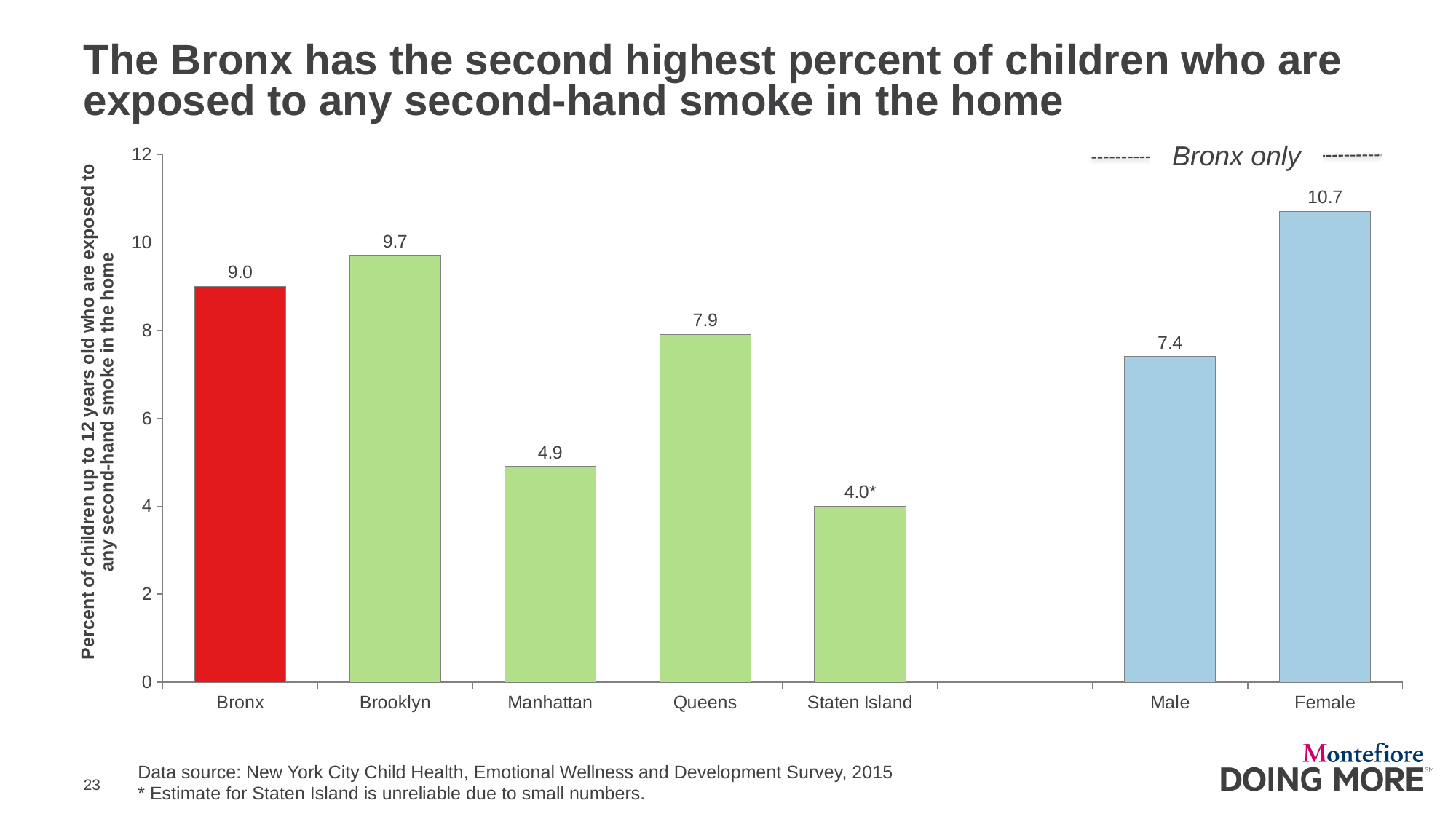
What is the value for Female in the Bronx only section? 10.7 What colour is the Bronx bar? Red What kind of chart is shown on the slide? Bar chart What is the difference between the values for Brooklyn and Bronx? 0.7 Which borough has the lowest value? Staten Island What is the value for Bronx? 9.0 What is the value for Staten Island? 4.0* What is the value for Brooklyn? 9.7 Which borough has the highest value? Brooklyn Which is larger, the value for Queens or the value for Manhattan? Queens What is the difference between the values for Female and Male? 3.3 How many bars are plotted on the chart? 7